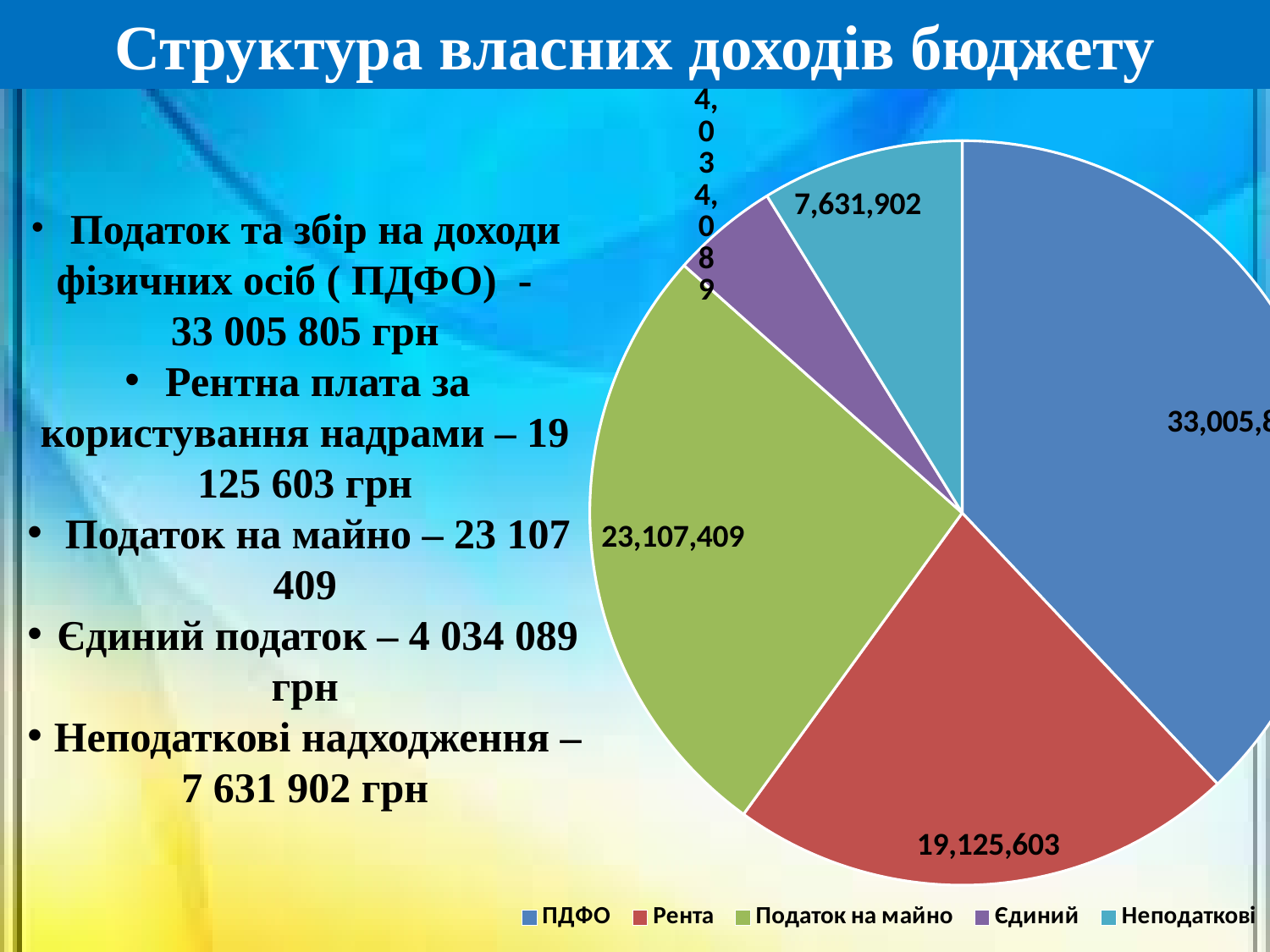
What is the title of the slide containing the chart? Структура власних доходів бюджету What is the value shown for Рента? 19,125,603 How many entries does the chart legend list? 5 How many slices does the pie chart have? 5 What is the difference between Податок на майно and Рента? 3,981,806 Which is larger, Рента or Податок на майно? Податок на майно What is the value shown for Податок на майно? 23,107,409 What is the value shown for Неподаткові? 7,631,902 What kind of chart is shown on the slide? pie chart Which category has the smallest slice of the pie? Єдиний What is the value shown for Єдиний? 4,034,089 Which category has the largest slice of the pie? ПДФО